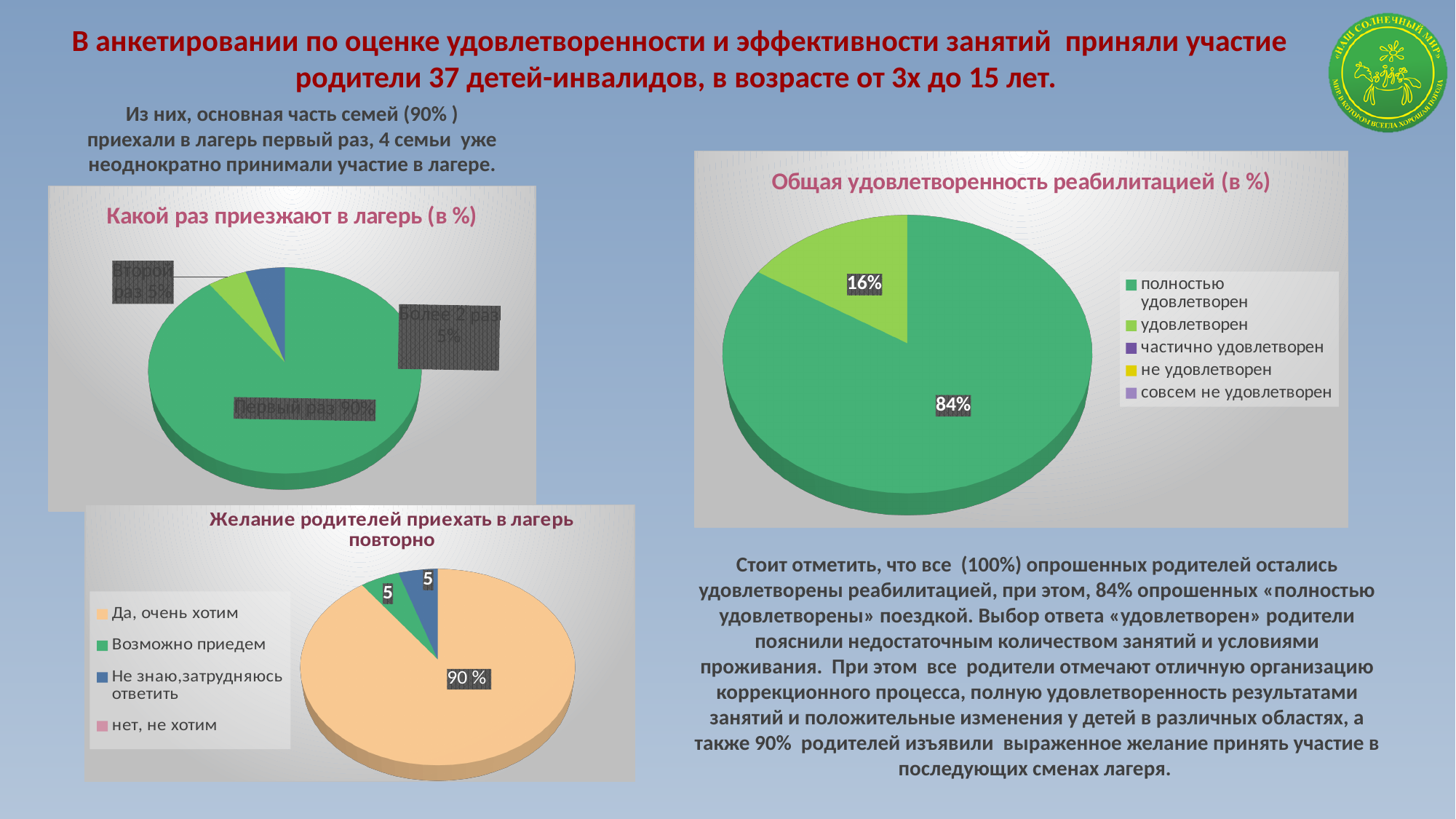
On the chart 'Общая удовлетворенность реабилитацией (в %)', what share is labelled for 'удовлетворен'? 16% On the chart 'Какой раз приезжают в лагерь (в %)', which category has the largest slice? Первый раз On the chart 'Какой раз приезжают в лагерь (в %)', what share is labelled for 'Первый раз'? 90% On the chart 'Желание родителей приехать в лагерь повторно', how many entries does the legend list? 4 On the chart 'Общая удовлетворенность реабилитацией (в %)', what is the difference between the 'полностью удовлетворен' and 'удовлетворен' shares? 68% On the chart 'Желание родителей приехать в лагерь повторно', which category has the largest slice? Да, очень хотим On the chart 'Общая удовлетворенность реабилитацией (в %)', how many entries does the legend list? 5 What kind of chart is 'Общая удовлетворенность реабилитацией (в %)'? Pie chart On the chart 'Желание родителей приехать в лагерь повторно', what value is labelled for 'Да, очень хотим'? 90 % On the chart 'Желание родителей приехать в лагерь повторно', what value is labelled for 'Возможно приедем'? 5 On the chart 'Общая удовлетворенность реабилитацией (в %)', what share is labelled for 'полностью удовлетворен'? 84% On the chart 'Какой раз приезжают в лагерь (в %)', what share is labelled for 'Второй раз'? 5%